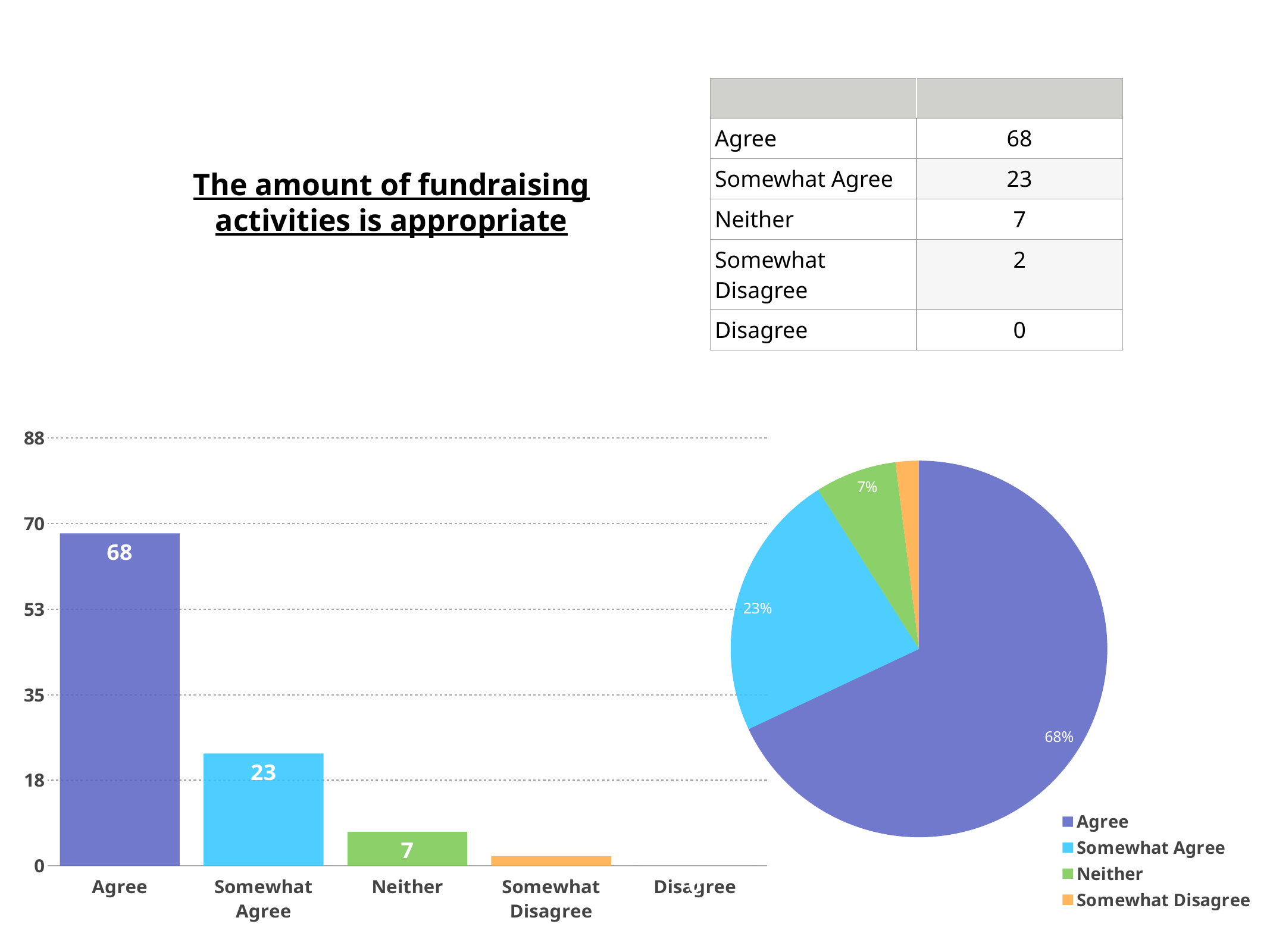
In the bar chart, which category has the highest value? Agree What kind of chart is shown at the bottom left of the slide? bar chart In the bar chart, which is larger, the value for Somewhat Agree or the value for Neither? Somewhat Agree In the bar chart, what is the value for Agree? 68 In the bar chart, what is the value for Somewhat Agree? 23 In the bar chart, what is the difference between the values for Agree and Somewhat Agree? 45 In the pie chart, what share does the Agree slice have? 68% In the bar chart, is the value for Somewhat Disagree greater or less than 18? less In the bar chart, what is the value for Neither? 7 How many categories are shown on the x axis of the bar chart? 5 How many entries does the legend of the pie chart list? 4 In the pie chart, what share does the Somewhat Agree slice have? 23%